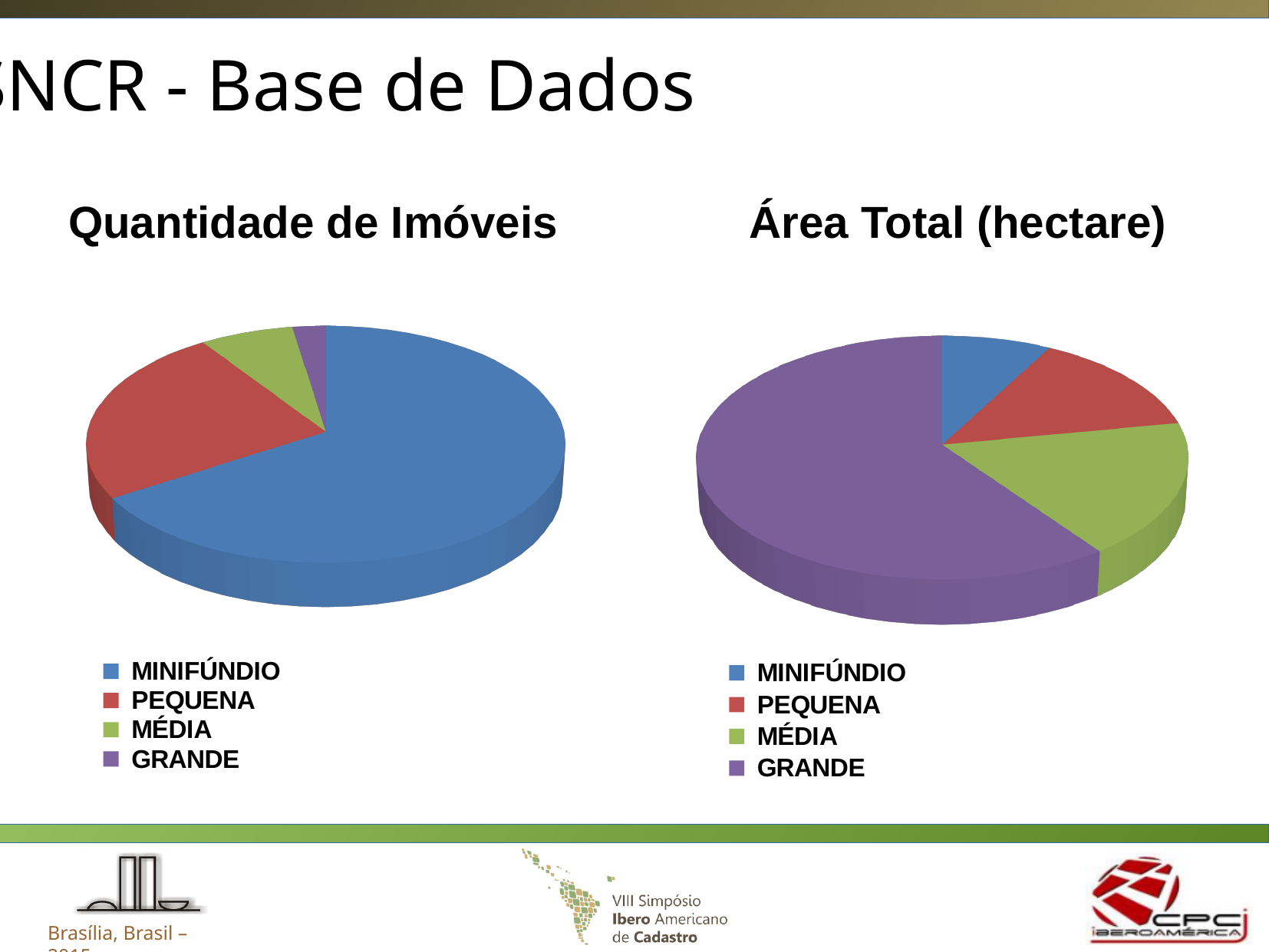
In the "Área Total (hectare)" chart, what colour represents GRANDE? Purple In the "Área Total (hectare)" chart, which category has the smallest slice? MINIFÚNDIO In the "Quantidade de Imóveis" chart, which slice is larger, MINIFÚNDIO or PEQUENA? MINIFÚNDIO In the "Área Total (hectare)" chart, which slice is larger, PEQUENA or MINIFÚNDIO? PEQUENA In the "Quantidade de Imóveis" chart, which slice is larger, MÉDIA or GRANDE? MÉDIA In the "Área Total (hectare)" chart, which category has the largest slice? GRANDE How many categories does the "Quantidade de Imóveis" chart show? 4 In the "Quantidade de Imóveis" chart, which category has the largest slice? MINIFÚNDIO What is the title of the chart on the right side of the slide? Área Total (hectare) In the "Quantidade de Imóveis" chart, which category has the smallest slice? GRANDE How many categories does the "Área Total (hectare)" chart show? 4 What kind of chart is the "Quantidade de Imóveis" chart? Pie chart